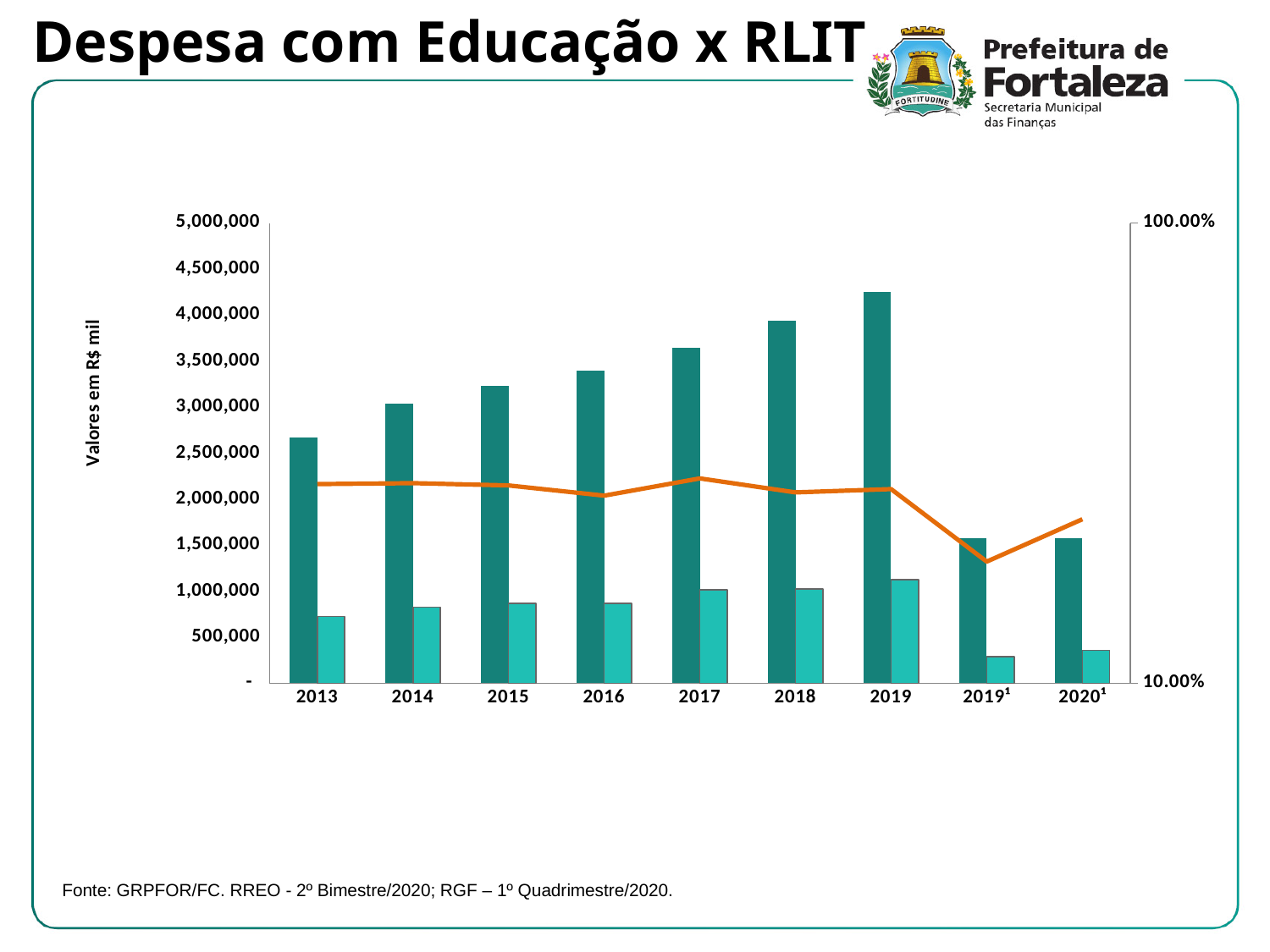
Which is larger, the dark teal bar for 2017 or the dark teal bar for 2015? 2017 How many year categories are shown on the x axis of the chart? 9 Is the light teal bar for 2019¹ greater or less than 500,000? less What is the title of the left vertical axis? Valores em R$ mil Is the dark teal bar for 2019 greater or less than 4,000,000? greater What kind of chart is shown on the slide? Bar chart combined with a line Is the light teal bar for 2013 greater or less than 500,000? greater Which year has the tallest light teal bar? 2019 Do the dark teal bars rise or fall from 2013 to 2019? rise Which year has the tallest dark teal bar? 2019 Which year has the shortest light teal bar? 2019¹